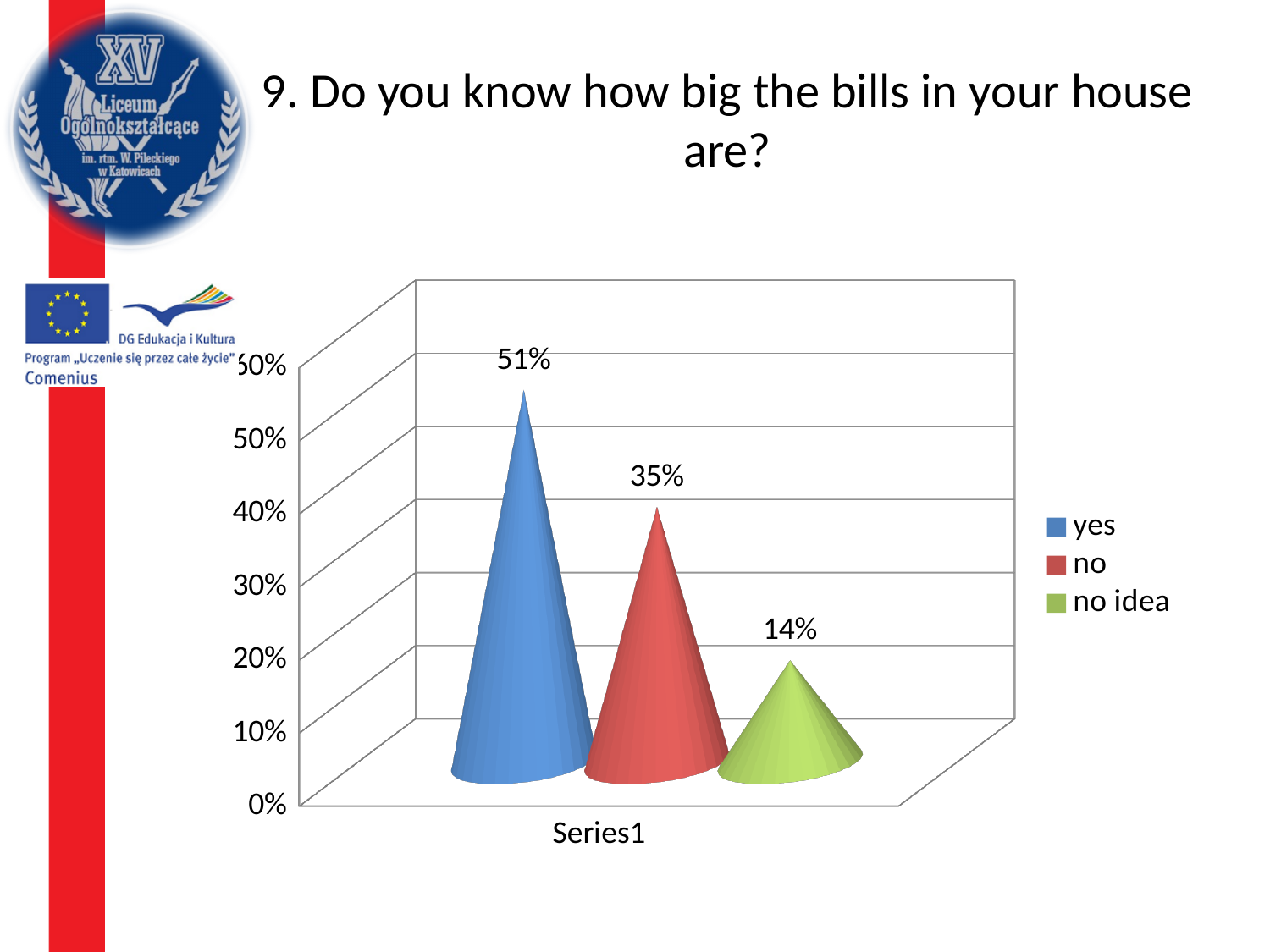
What is the label shown on the horizontal axis of the chart? Series1 Which answer has the highest percentage? yes What is the difference between the "no" and "no idea" percentages? 21% Which answer has the lowest percentage? no idea How many entries does the legend list? 3 What percentage of respondents answered "no idea"? 14% What is the difference between the "yes" and "no" percentages? 16% Which is larger, the value for "no" or the value for "no idea"? no What percentage of respondents answered "yes"? 51% What colour represents the "no idea" answer in the chart? green Is the value for "yes" greater or less than 50%? greater What percentage of respondents answered "no"? 35%